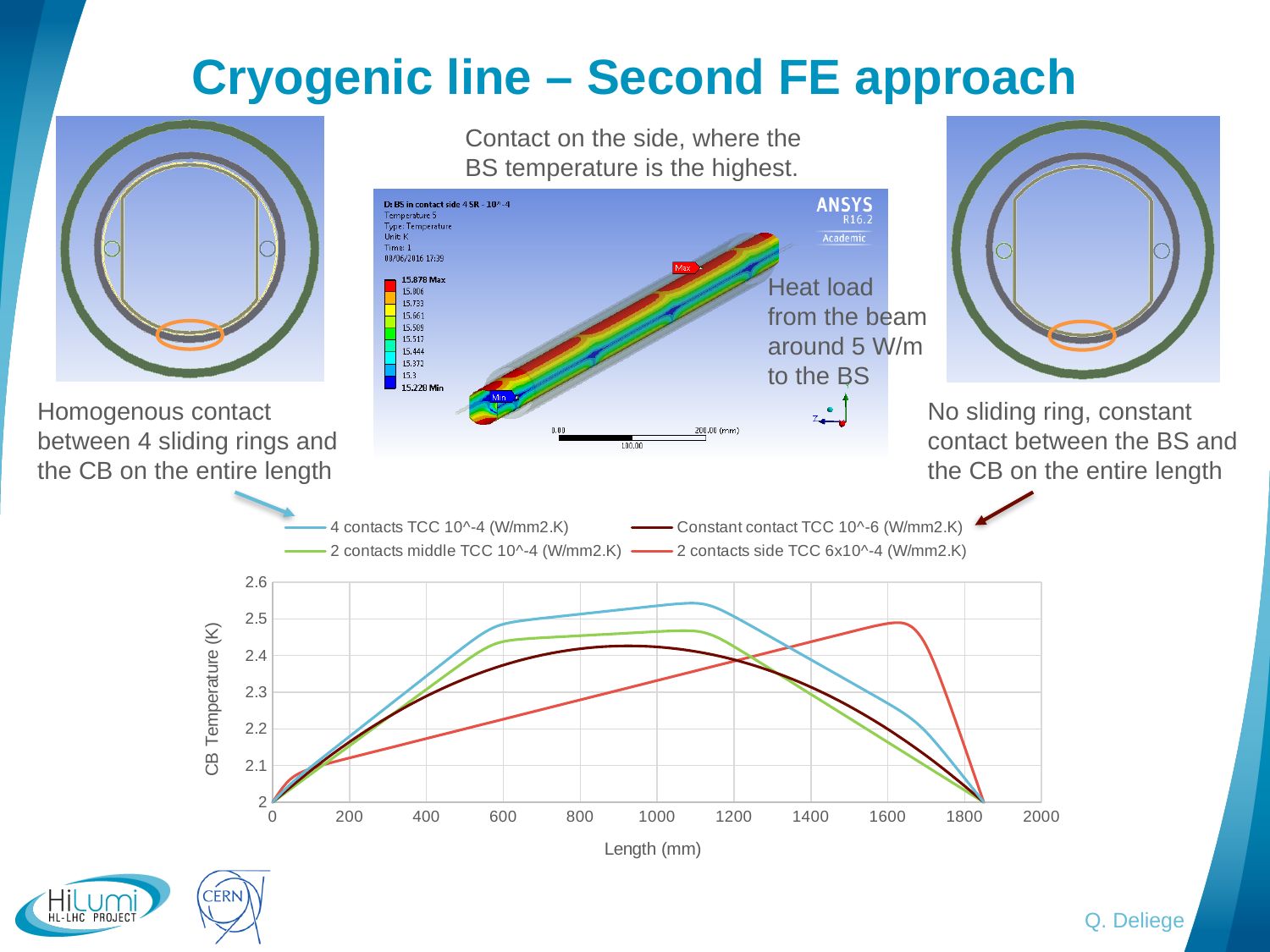
Which series reaches the highest CB temperature on the chart? 4 contacts TCC 10^-4 (W/mm2.K) What is the title of the vertical axis of the chart? CB Temperature (K) What kind of chart is shown on the slide? line chart What is the maximum value shown on the vertical axis of the chart? 2.6 What is the title of the horizontal axis of the chart? Length (mm) How many series does the chart legend list? 4 Is the value of the '4 contacts TCC 10^-4 (W/mm2.K)' series at a length of 1000 mm greater or less than 2.5? greater Does the '2 contacts side TCC 6x10^-4 (W/mm2.K)' series rise or fall between a length of 0 mm and 1600 mm? rise Is the value of the '2 contacts middle TCC 10^-4 (W/mm2.K)' series at a length of 800 mm greater or less than 2.4? greater Is the value of the '2 contacts side TCC 6x10^-4 (W/mm2.K)' series at a length of 800 mm greater or less than 2.3? less At a length of 1600 mm, which series has the higher CB temperature: '2 contacts side TCC 6x10^-4 (W/mm2.K)' or '4 contacts TCC 10^-4 (W/mm2.K)'? 2 contacts side TCC 6x10^-4 (W/mm2.K) At a length of 800 mm, which series has the higher CB temperature: '4 contacts TCC 10^-4 (W/mm2.K)' or '2 contacts side TCC 6x10^-4 (W/mm2.K)'? 4 contacts TCC 10^-4 (W/mm2.K)